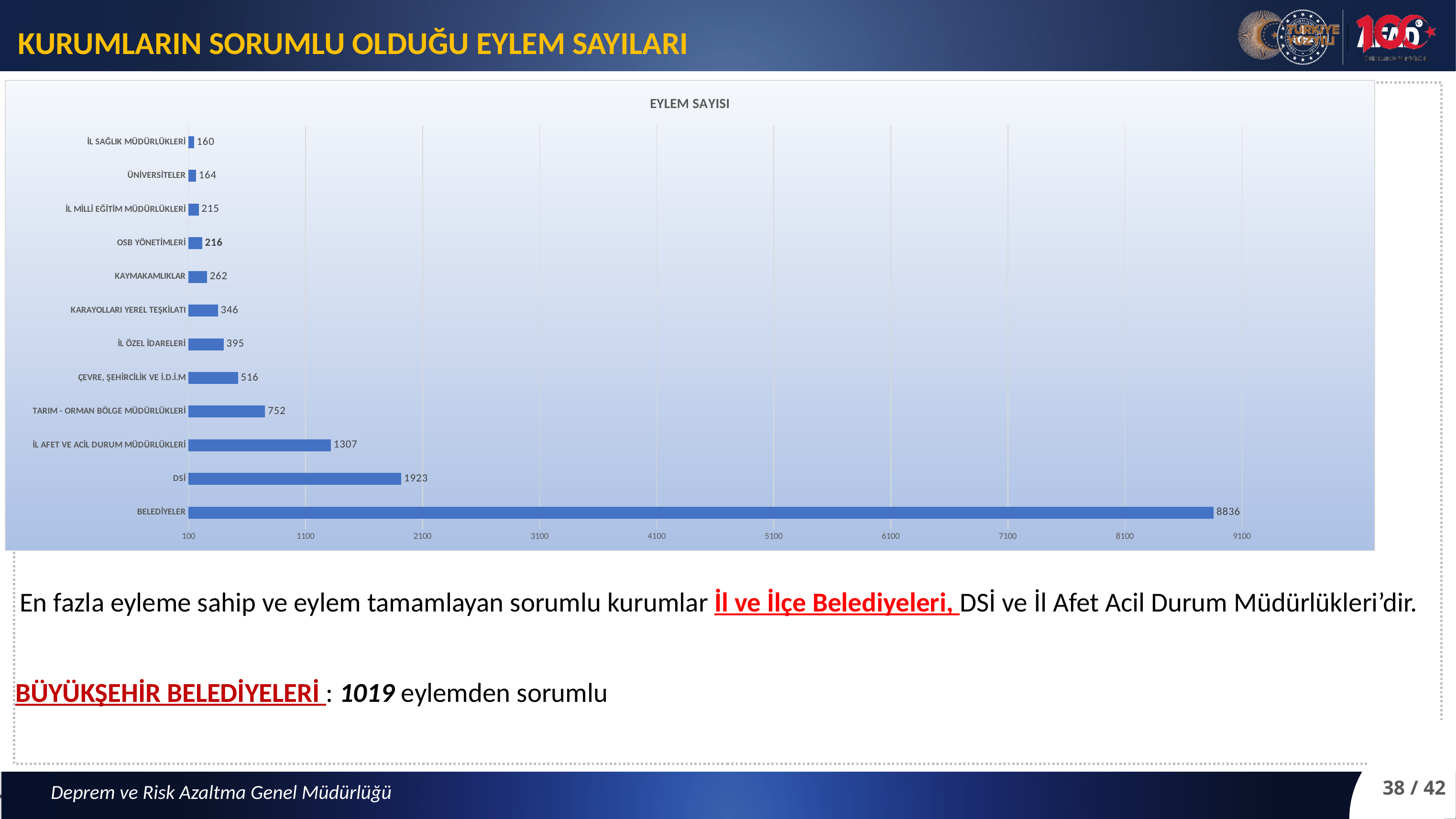
What is the title of the chart? EYLEM SAYISI Which is larger, the value for TARIM - ORMAN BÖLGE MÜDÜRLÜKLERİ or the value for ÇEVRE, ŞEHİRCİLİK VE İ.D.İ.M? TARIM - ORMAN BÖLGE MÜDÜRLÜKLERİ What is the value for KAYMAKAMLIKLAR? 262 What is the difference between the values for DSİ and İL AFET VE ACİL DURUM MÜDÜRLÜKLERİ? 616 What kind of chart is shown on the slide? bar chart What is the value for BELEDİYELER? 8836 How many categories are shown in the chart? 12 What is the value for İL AFET VE ACİL DURUM MÜDÜRLÜKLERİ? 1307 What is the difference between the values for BELEDİYELER and DSİ? 6913 What is the value for DSİ? 1923 Which category has the highest value? BELEDİYELER Which category has the lowest value? İL SAĞLIK MÜDÜRLÜKLERİ